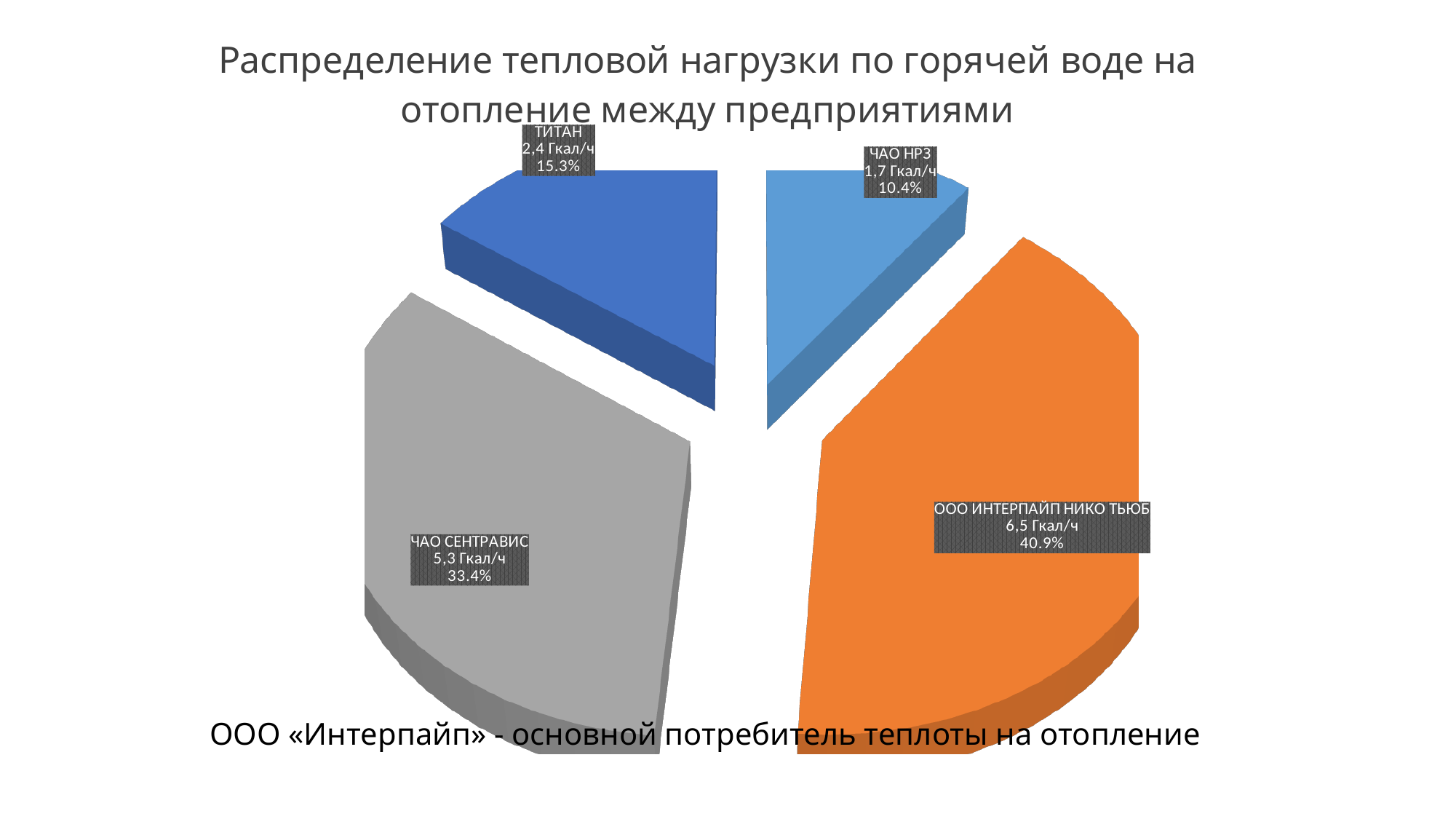
Which has a larger heat load, ТИТАН or ЧАО СЕНТРАВИС? ЧАО СЕНТРАВИС What percentage share of the pie does ЧАО НРЗ have? 10.4% What is the heat load value for ТИТАН? 2,4 Гкал/ч What percentage share of the pie does ЧАО СЕНТРАВИС have? 33.4% Which enterprise has the largest share of the heat load? ООО ИНТЕРПАЙП НИКО ТЬЮБ What is the heat load value for ЧАО НРЗ? 1,7 Гкал/ч How many slices does the pie chart have? 4 Which enterprise has the smallest share of the heat load? ЧАО НРЗ What colour is the slice for ЧАО СЕНТРАВИС? Grey What is the difference in percentage share between ООО ИНТЕРПАЙП НИКО ТЬЮБ and ЧАО СЕНТРАВИС? 7.5% What kind of chart is shown on the slide? Pie chart What is the heat load value for ООО ИНТЕРПАЙП НИКО ТЬЮБ? 6,5 Гкал/ч